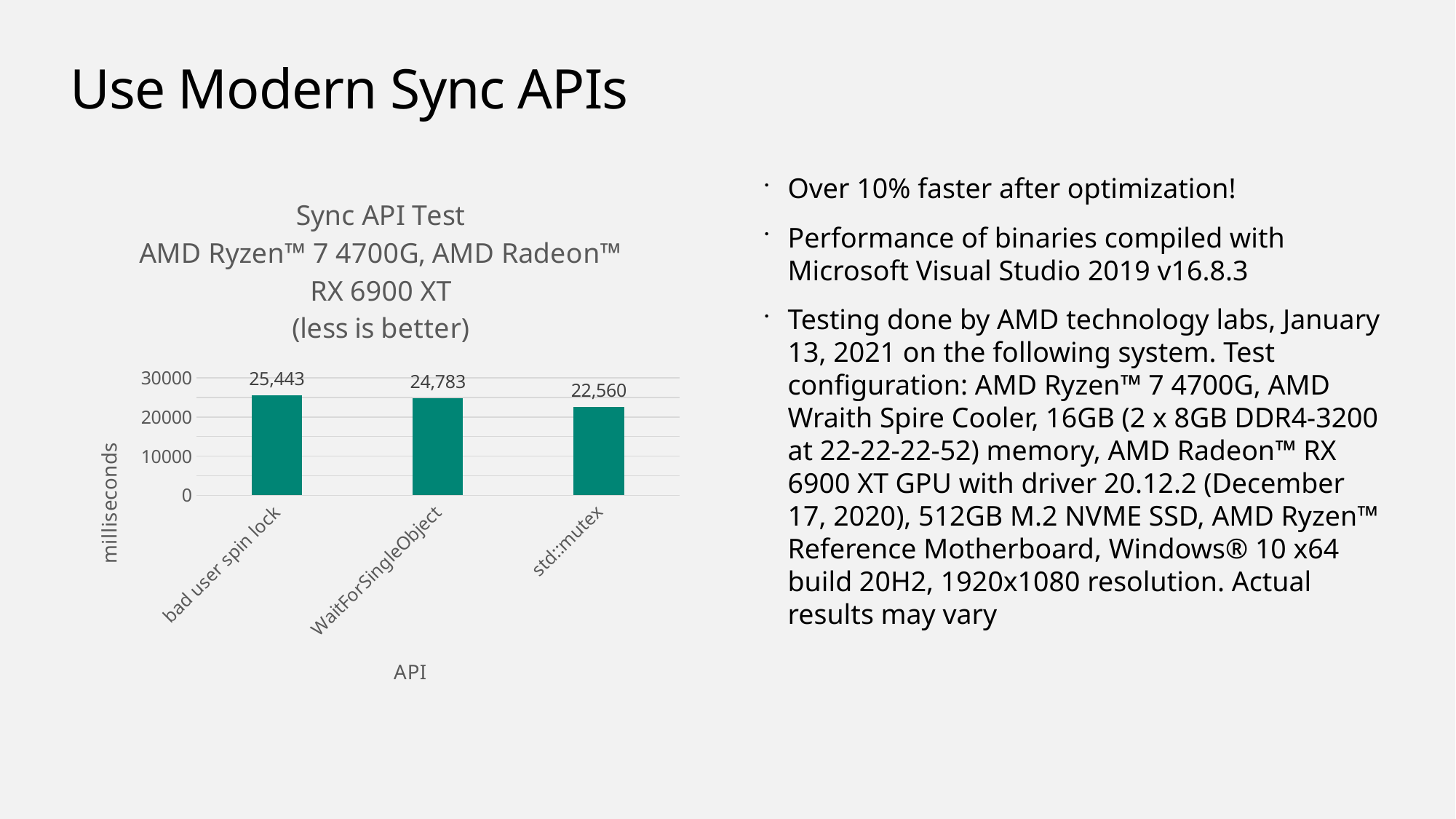
What is the difference between the values for WaitForSingleObject and std::mutex? 2,223 What is the value for bad user spin lock? 25,443 What is the value for std::mutex? 22,560 Which API has the highest value? bad user spin lock How many APIs are shown on the chart? 3 What is the difference between the values for bad user spin lock and std::mutex? 2,883 Which API has the lowest value? std::mutex What kind of chart is shown? bar chart Which is larger, the value for bad user spin lock or the value for std::mutex? bad user spin lock Is the value for std::mutex greater or less than 20000? greater What is the label of the vertical axis? milliseconds What is the value for WaitForSingleObject? 24,783